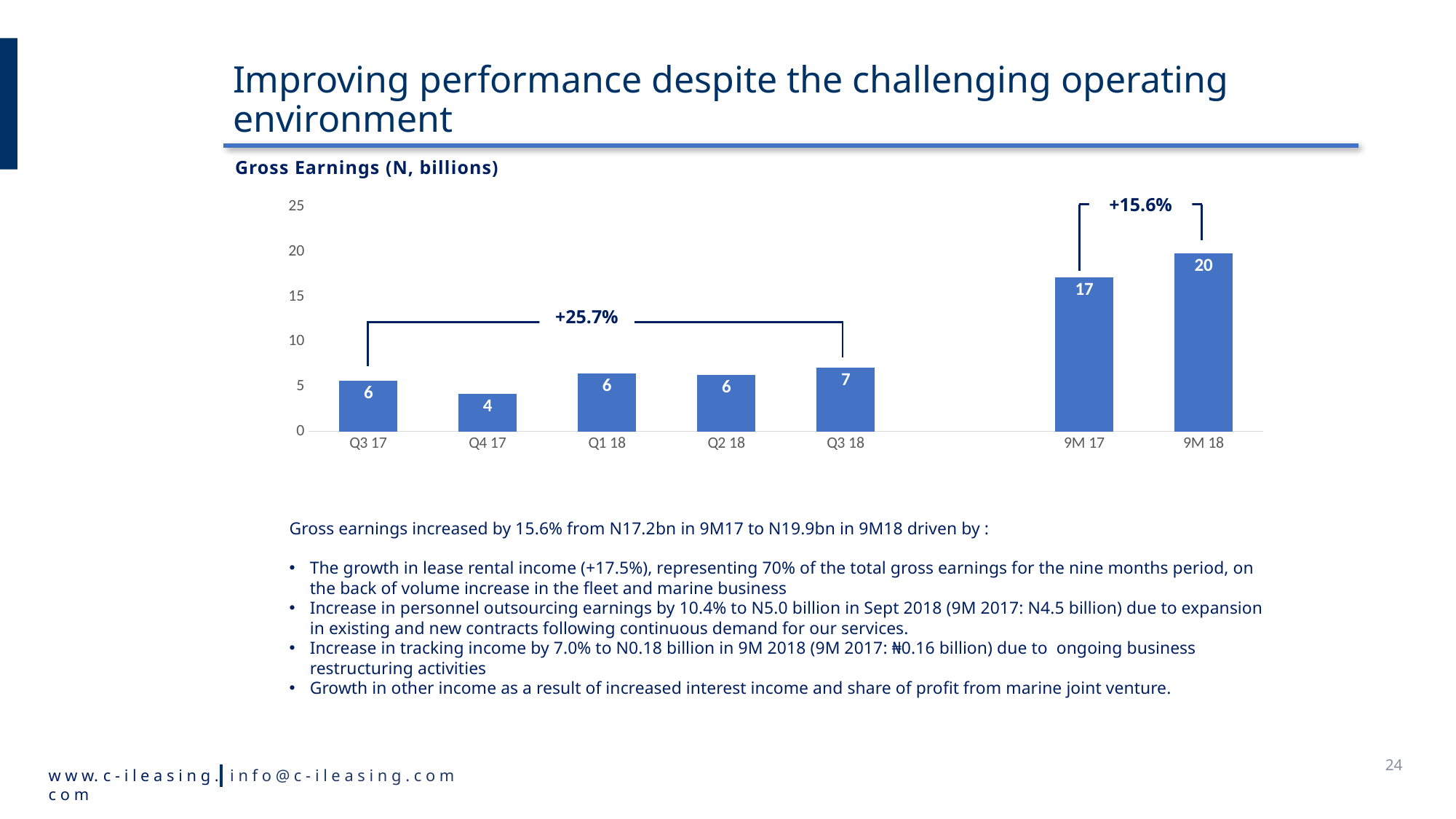
Is the value for 9M 17 in the Gross Earnings chart greater or less than 15? greater What is the difference between the 9M 18 and 9M 17 values in the Gross Earnings chart? 3 Do the values rise or fall from Q4 17 to Q3 18 in the Gross Earnings chart? Rise What is the value for 9M 18 in the Gross Earnings chart? 20 Which category has the highest value in the Gross Earnings chart? 9M 18 What kind of chart is used to show Gross Earnings? Bar chart How many categories are shown on the x axis of the Gross Earnings chart? 7 What percentage change is annotated between 9M 17 and 9M 18 in the Gross Earnings chart? +15.6% Which is larger in the Gross Earnings chart, the value for Q3 18 or the value for Q4 17? Q3 18 What is the value for Q3 18 in the Gross Earnings chart? 7 What is the value for Q4 17 in the Gross Earnings chart? 4 Which category has the lowest value in the Gross Earnings chart? Q4 17